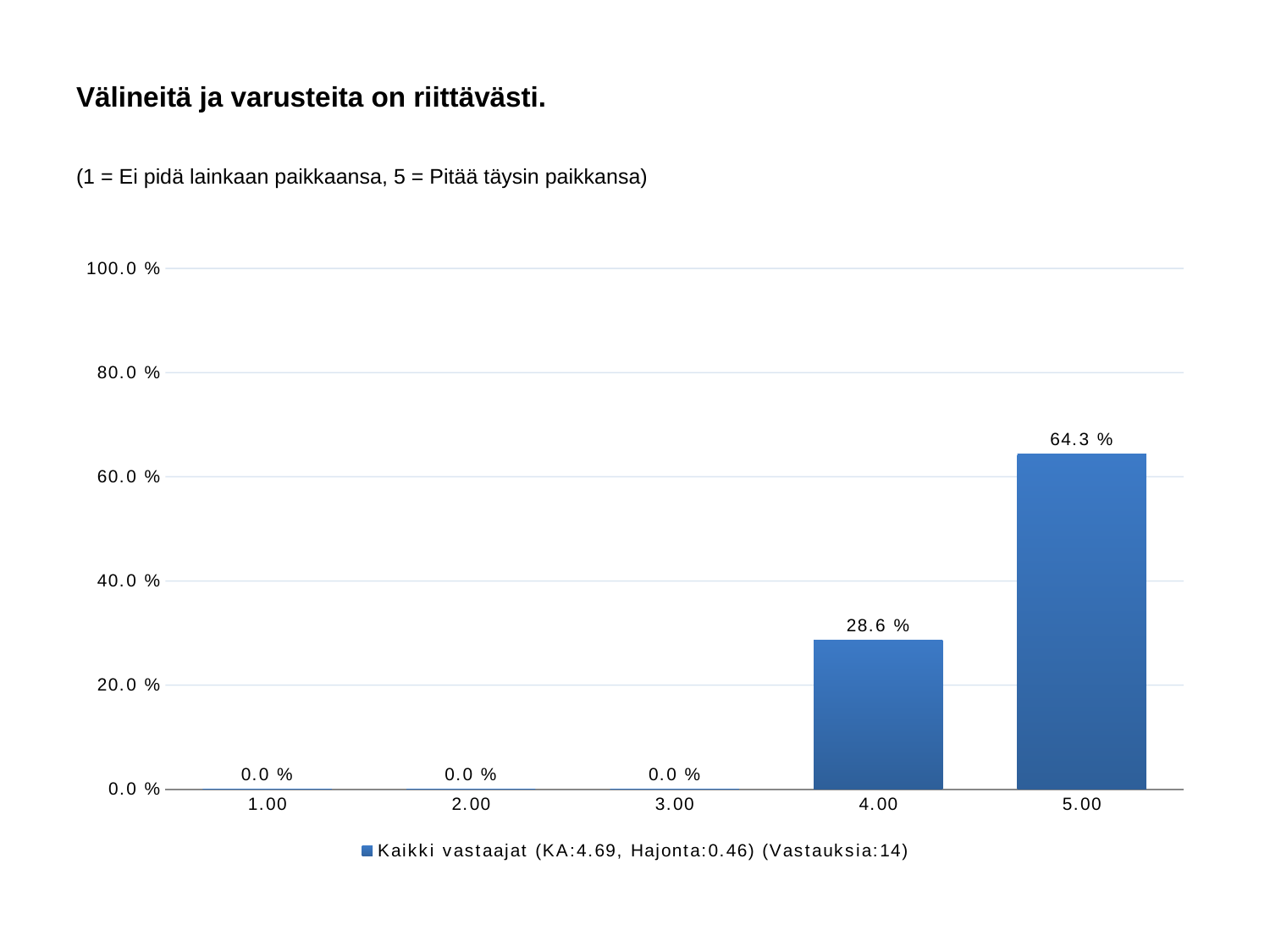
What is the difference between the values for 5.00 and 4.00? 35.7 % Is the value for 4.00 greater or less than 40.0 %? less How many categories are shown on the x axis? 5 What kind of chart is shown? bar chart Which category has the highest value? 5.00 What is the value for category 5.00? 64.3 % What is the title of the chart? Välineitä ja varusteita on riittävästi. What is the value for category 4.00? 28.6 % How many series does the legend list? 1 What is the value for category 1.00? 0.0 % Which is larger, the value for 4.00 or the value for 5.00? 5.00 Is the value for 5.00 greater or less than 60.0 %? greater